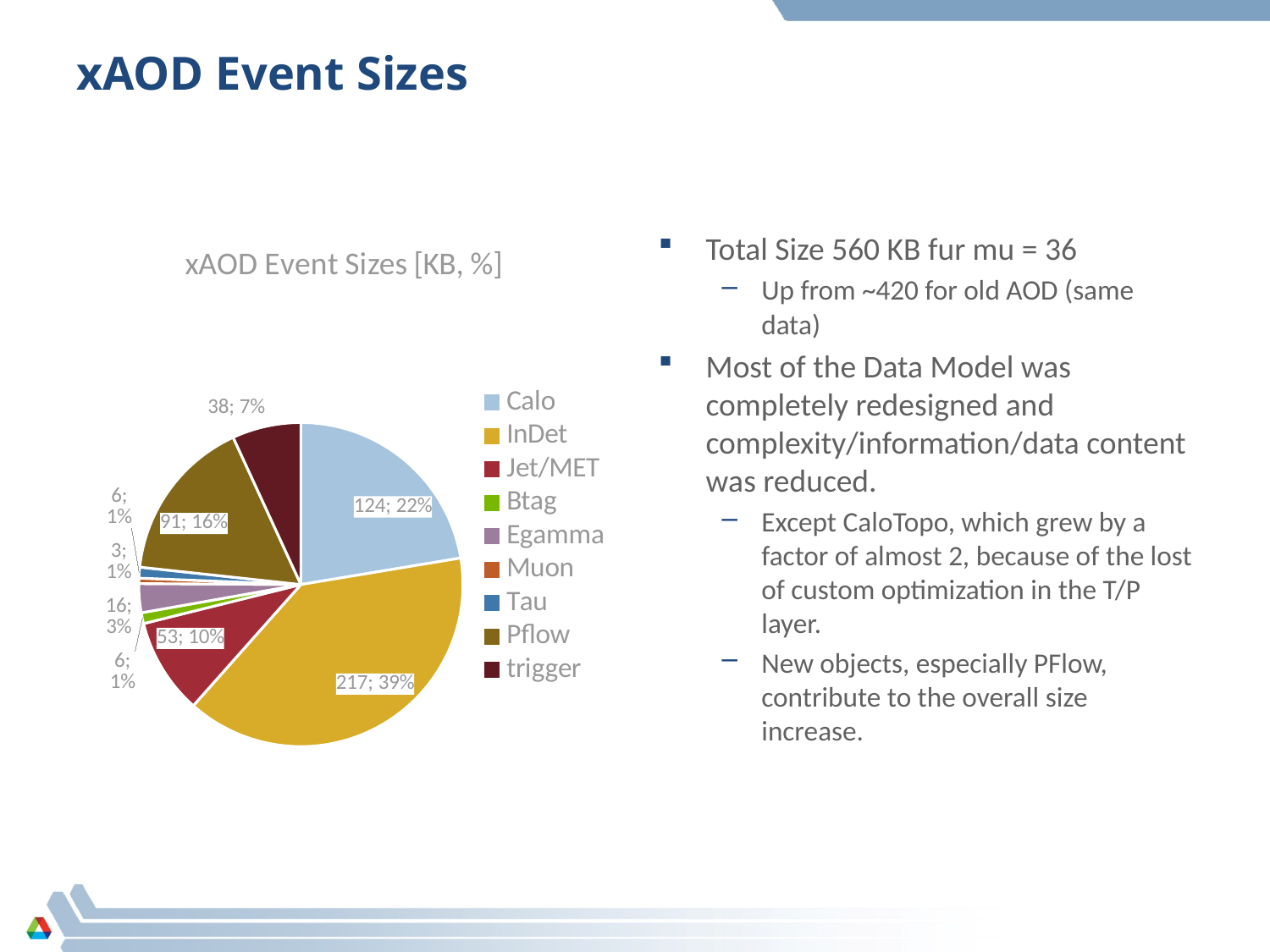
What is the size in KB of the InDet slice? 217 What is the title of the chart? xAOD Event Sizes [KB, %] What is the difference in KB between the InDet and Calo slices? 93 How many categories does the legend of the pie chart list? 9 What kind of chart is shown on the slide? pie chart Which category has the smallest slice of the pie? Muon Which category has the largest slice of the pie? InDet What percentage share does the Calo slice have? 22% What percentage share does the trigger slice have? 7% What is the size in KB of the Pflow slice? 91 What is the size in KB of the Egamma slice? 16 Which is larger, the Jet/MET slice or the Pflow slice? Pflow